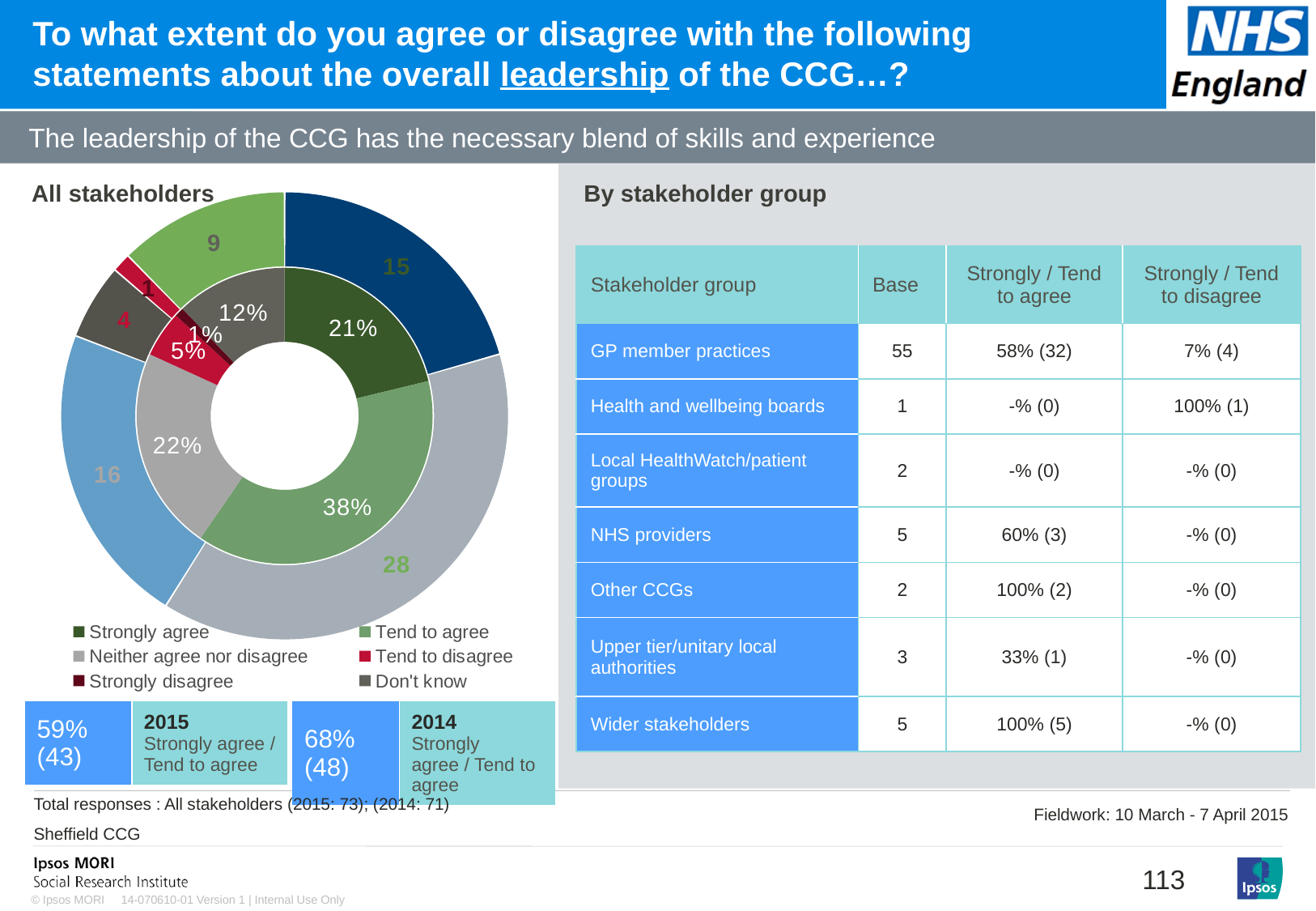
In the 'All stakeholders' chart, what percentage of respondents 'Tend to agree'? 38% How many response categories does the legend of the 'All stakeholders' chart list? 6 In the 'All stakeholders' chart, what percentage of respondents 'Strongly agree'? 21% In the 'All stakeholders' chart, what is the difference in percentage points between 'Tend to agree' and 'Strongly agree'? 17 In the 'All stakeholders' chart, what percentage of respondents 'Tend to disagree'? 5% In the 'All stakeholders' chart, which response category has the largest share? Tend to agree In the 'All stakeholders' chart, which response category has the smallest share? Strongly disagree In the 'All stakeholders' chart, what is the combined percentage for 'Strongly agree' and 'Tend to agree'? 59% What type of chart is shown under 'All stakeholders'? doughnut chart In the 'All stakeholders' chart, which is larger: the share for 'Neither agree nor disagree' or the share for 'Don't know'? Neither agree nor disagree In the 'All stakeholders' chart, what percentage of respondents answered 'Don't know'? 12% In the 'All stakeholders' chart, what percentage of respondents answered 'Neither agree nor disagree'? 22%